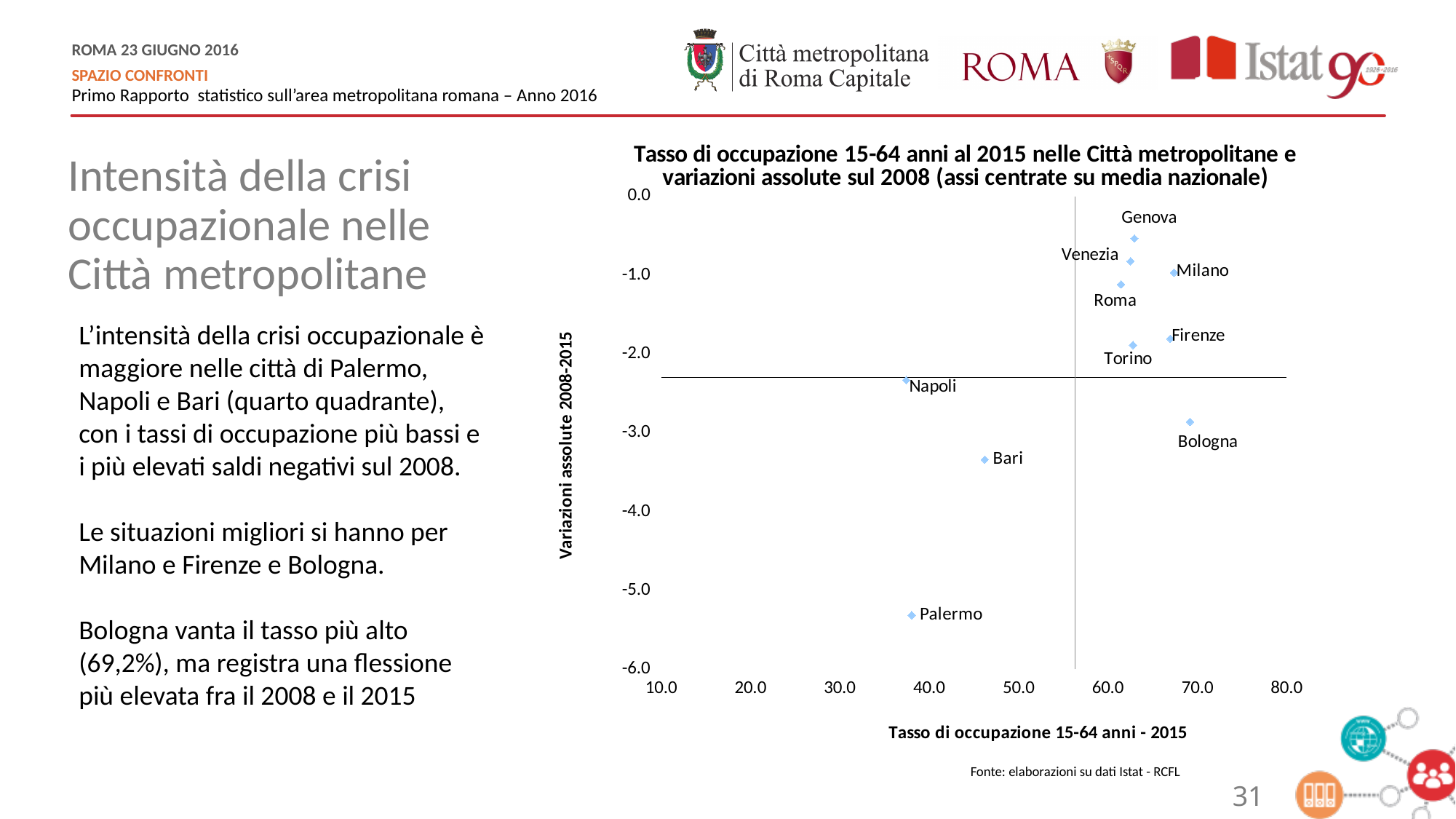
How many cities are plotted on the chart? 10 Which city has the higher horizontal-axis value, Milano or Roma? Milano Is the horizontal-axis value for Napoli greater or less than 40.0? less Is the horizontal-axis value for Milano greater or less than 60.0? greater Which city has the highest value on the horizontal axis (Tasso di occupazione 15-64 anni - 2015)? Bologna What kind of chart is shown on the slide? scatter chart Is the vertical-axis value for Palermo greater or less than -5.0? less What is the label of the horizontal axis of the chart? Tasso di occupazione 15-64 anni - 2015 Which city has the highest value on the vertical axis (Variazioni assolute 2008-2015)? Genova Which city has the lowest value on the vertical axis (Variazioni assolute 2008-2015)? Palermo Which city has the lower vertical-axis value, Bari or Napoli? Bari